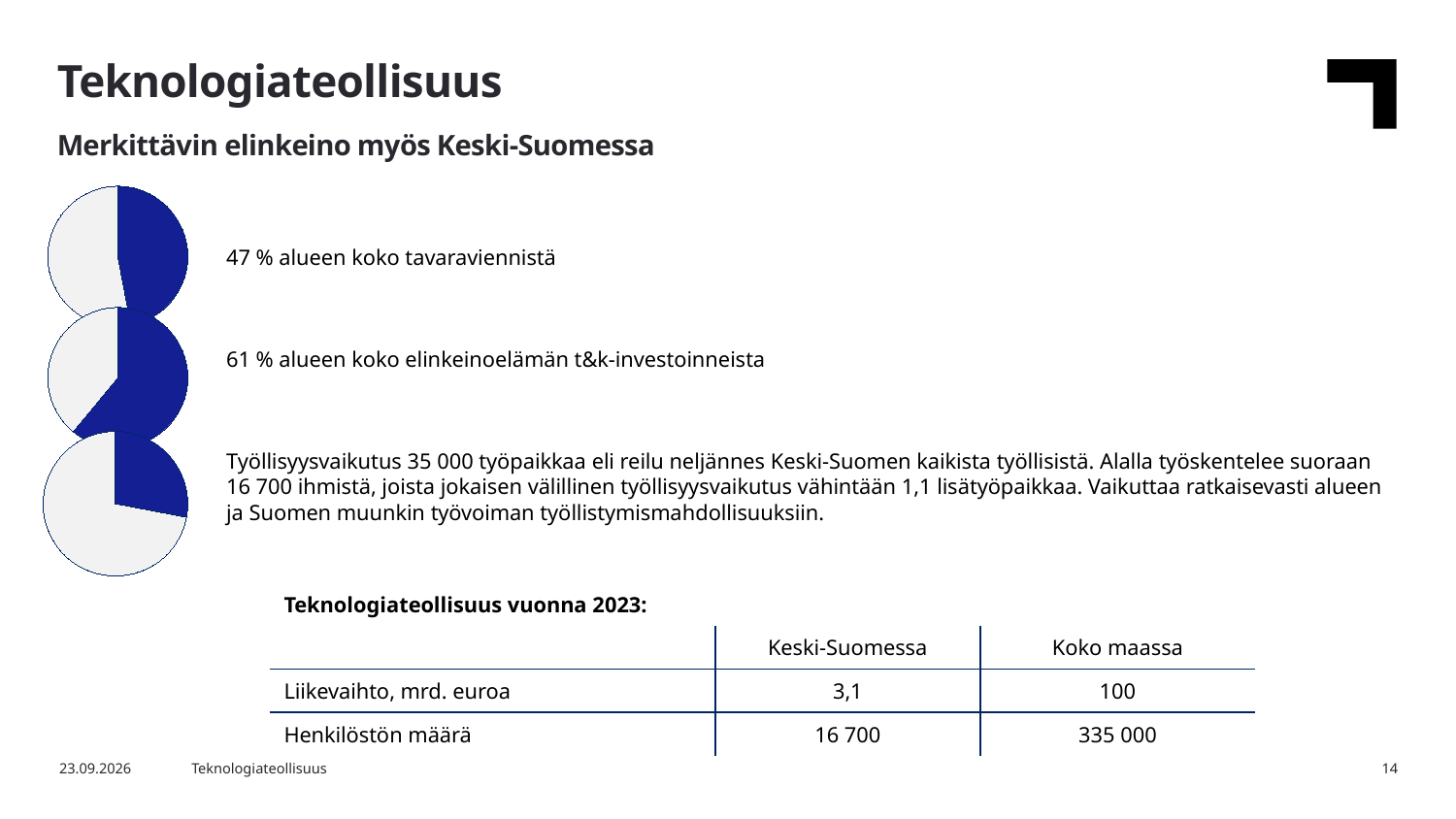
What does the top pie chart's blue slice represent, according to the text next to it? 47 % alueen koko tavaraviennistä Which pie chart has the largest blue slice: the top, middle or bottom one? Middle How many pie charts are on the slide? 3 Is the blue slice larger in the top pie chart or in the middle pie chart? Middle What is the difference in percentage points between the blue share in the middle pie chart (61 %) and the top pie chart (47 %)? 14 percentage points What kind of charts are shown on the left side of the slide? Pie charts What colour is used for the highlighted slice in each pie chart? Blue In the middle pie chart, what share of the region's business R&D investments (t&k-investoinnit) does the blue slice represent? 61 % Is the blue slice in the middle pie chart greater or less than 50 %? greater Which pie chart has the smallest blue slice: the top, middle or bottom one? Bottom Is the blue slice in the bottom pie chart greater or less than 50 %? less In the top pie chart, what share of the region's total goods exports (tavaravienti) does the blue slice represent? 47 %